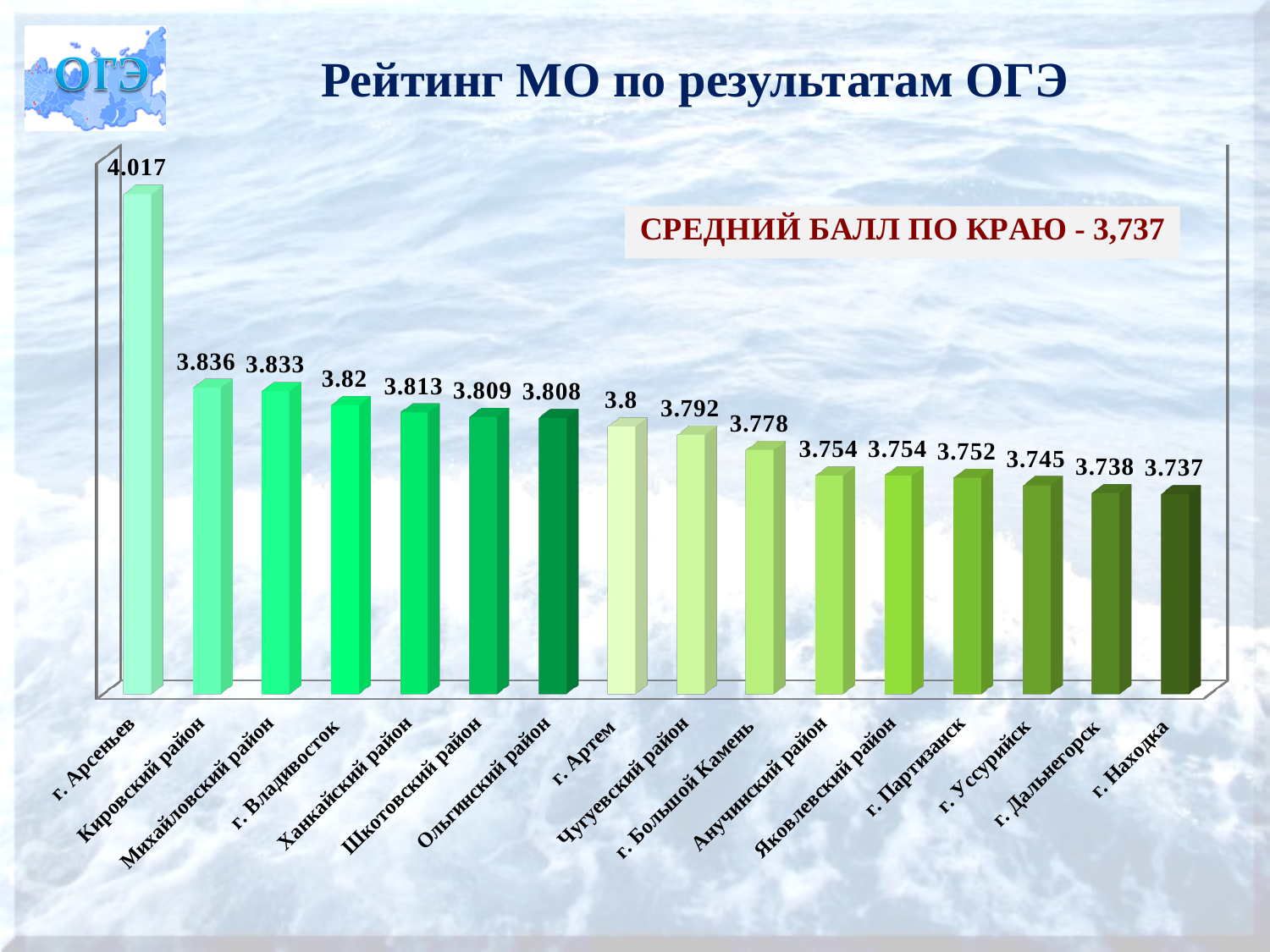
What value is shown for г. Большой Камень? 3.778 Which category has the lowest value? г. Находка What value is shown for г. Владивосток? 3.82 What is the difference between the values for г. Арсеньев and г. Находка? 0.28 What is the difference between the values for Кировский район and г. Артем? 0.036 What value is shown for г. Уссурийск? 3.745 What value is shown for г. Арсеньев? 4.017 What kind of chart is shown on the slide? Bar chart Which is larger, the value for Михайловский район or the value for Чугуевский район? Михайловский район How many categories are shown on the chart? 16 Do the values rise or fall from left to right along the x axis? Fall Which category has the highest value? г. Арсеньев